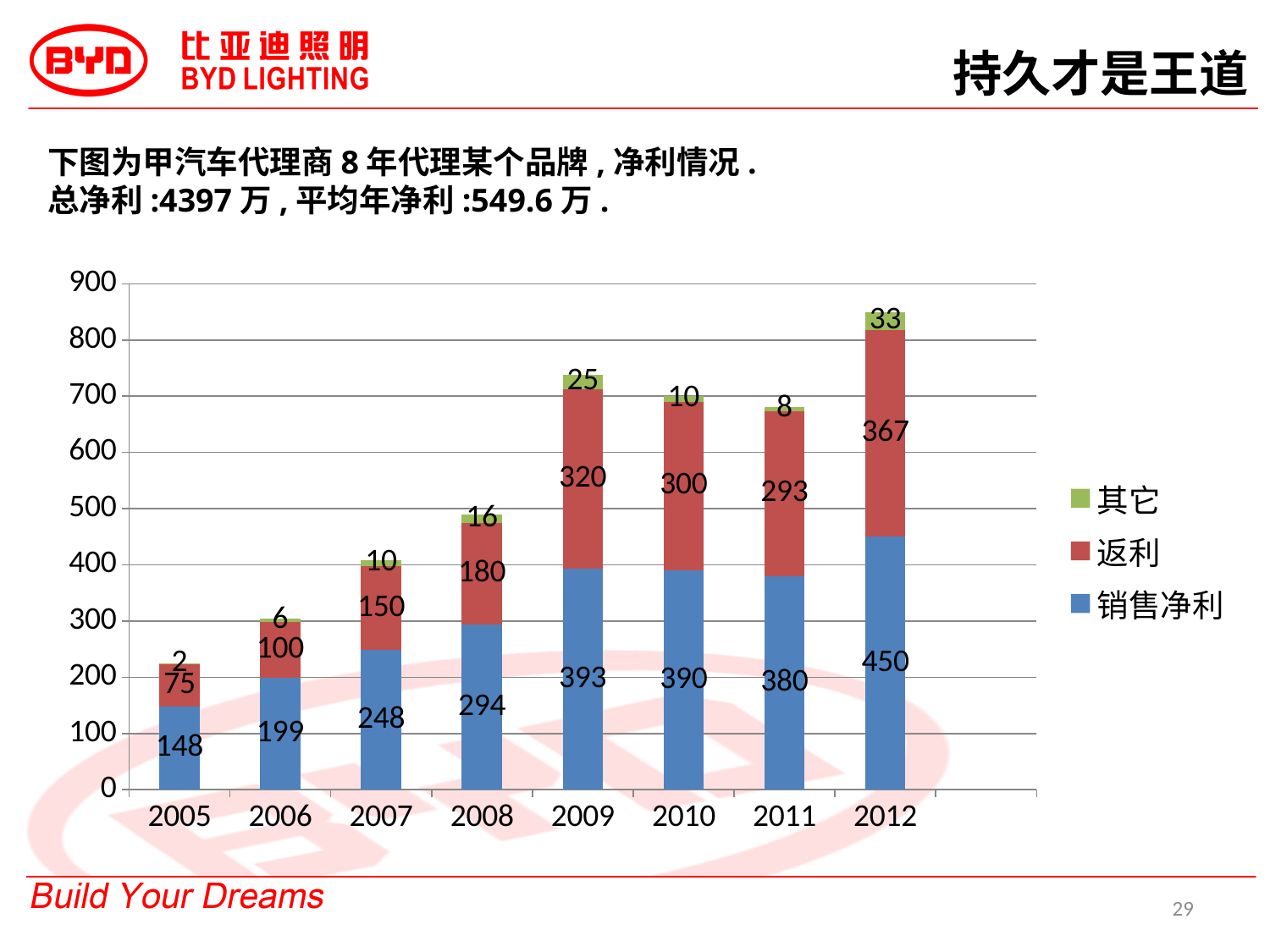
How many years are shown on the x axis? 8 Which is larger, the 返利 value for 2009 or for 2010? 2009 Which year has the highest 销售净利 value? 2012 How many series does the legend list? 3 What is the difference between the 销售净利 values for 2012 and 2005? 302 What is the 销售净利 value for 2009? 393 What is the 返利 value for 2012? 367 What is the 其它 value for 2008? 16 What is the total of the stacked bar for 2012? 850 What kind of chart is shown on the slide? Stacked bar chart What is the total of the stacked bar for 2005? 225 Which year has the lowest 返利 value? 2005